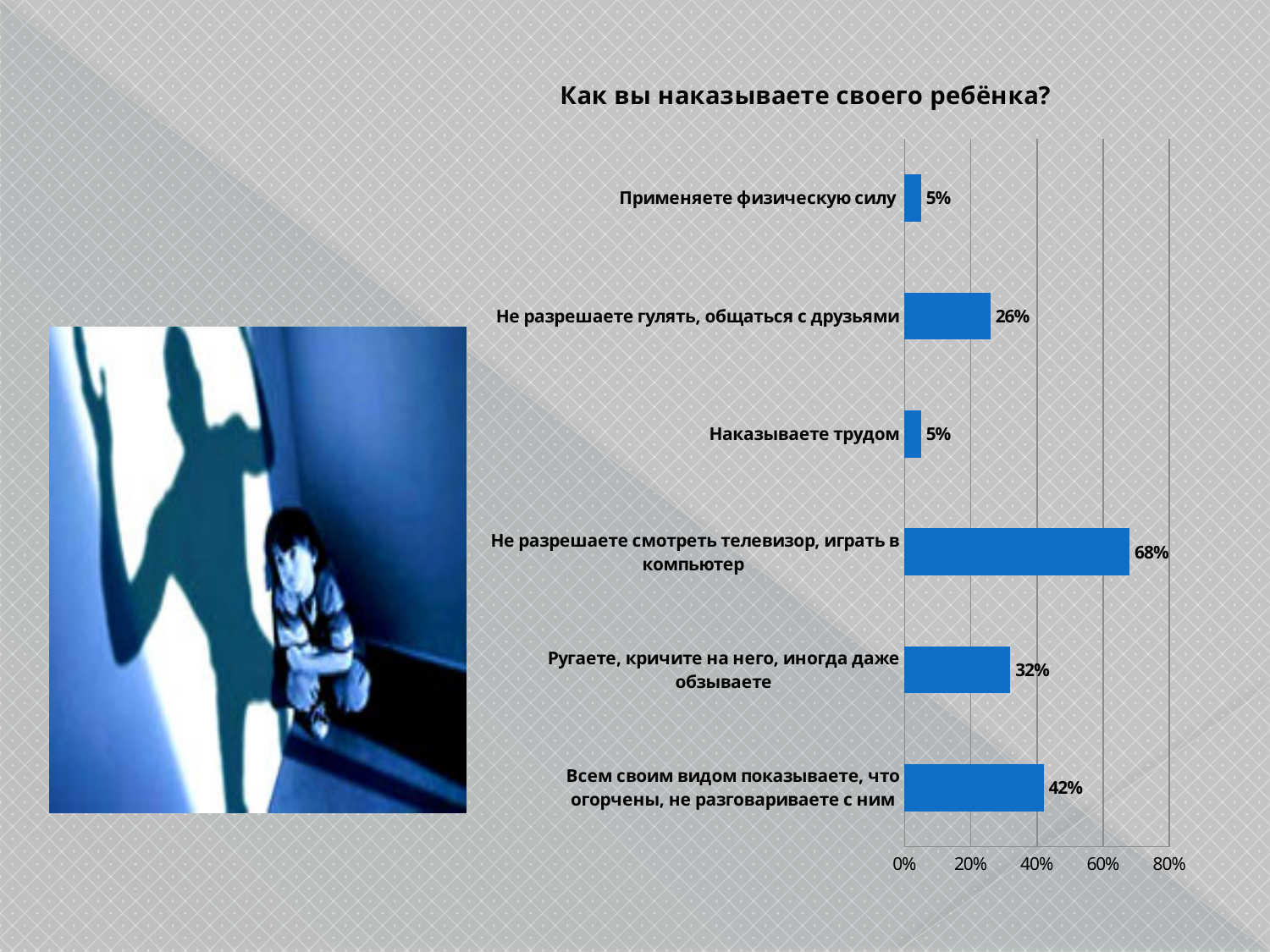
Which category has the highest value? Не разрешаете смотреть телевизор, играть в компьютер What is the value for "Не разрешаете смотреть телевизор, играть в компьютер"? 68% Is the value for "Всем своим видом показываете, что огорчены, не разговариваете с ним" greater or less than 40%? greater What is the title of the chart? Как вы наказываете своего ребёнка? What kind of chart is shown on the slide? bar chart What is the difference between "Не разрешаете смотреть телевизор, играть в компьютер" and "Всем своим видом показываете, что огорчены, не разговариваете с ним"? 26% What is the value for "Не разрешаете гулять, общаться с друзьями"? 26% How many categories are shown in the chart? 6 Which is larger: "Ругаете, кричите на него, иногда даже обзываете" or "Не разрешаете гулять, общаться с друзьями"? Ругаете, кричите на него, иногда даже обзываете What is the value for "Ругаете, кричите на него, иногда даже обзываете"? 32% What is the value for "Применяете физическую силу"? 5% What is the value for "Всем своим видом показываете, что огорчены, не разговариваете с ним"? 42%